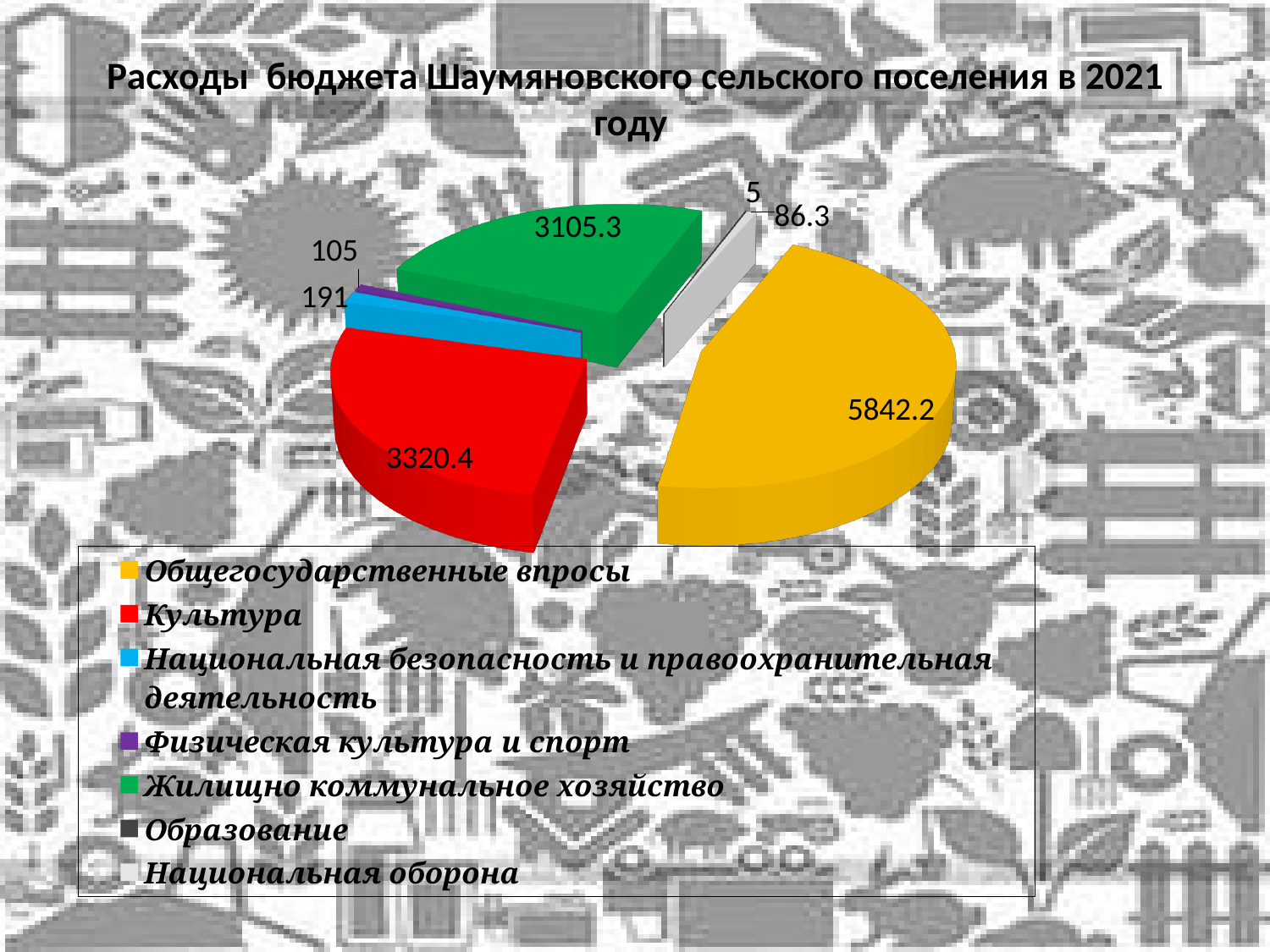
What is the value for Национальная безопасность и правоохранительная деятельность? 191 How many categories does the legend list? 7 What is the value for Общегосударственные впросы? 5842.2 What is the value for Физическая культура и спорт? 105 What is the value for Жилищно коммунальное хозяйство? 3105.3 What colour is the slice for Культура? Red What kind of chart is shown on the slide? Pie chart What is the difference between the values for Общегосударственные впросы and Культура? 2521.8 Which category has the largest slice of the pie? Общегосударственные впросы Which is larger, Культура or Жилищно коммунальное хозяйство? Культура What is the value for Культура? 3320.4 What is the title of the chart? Расходы бюджета Шаумяновского сельского поселения в 2021 году